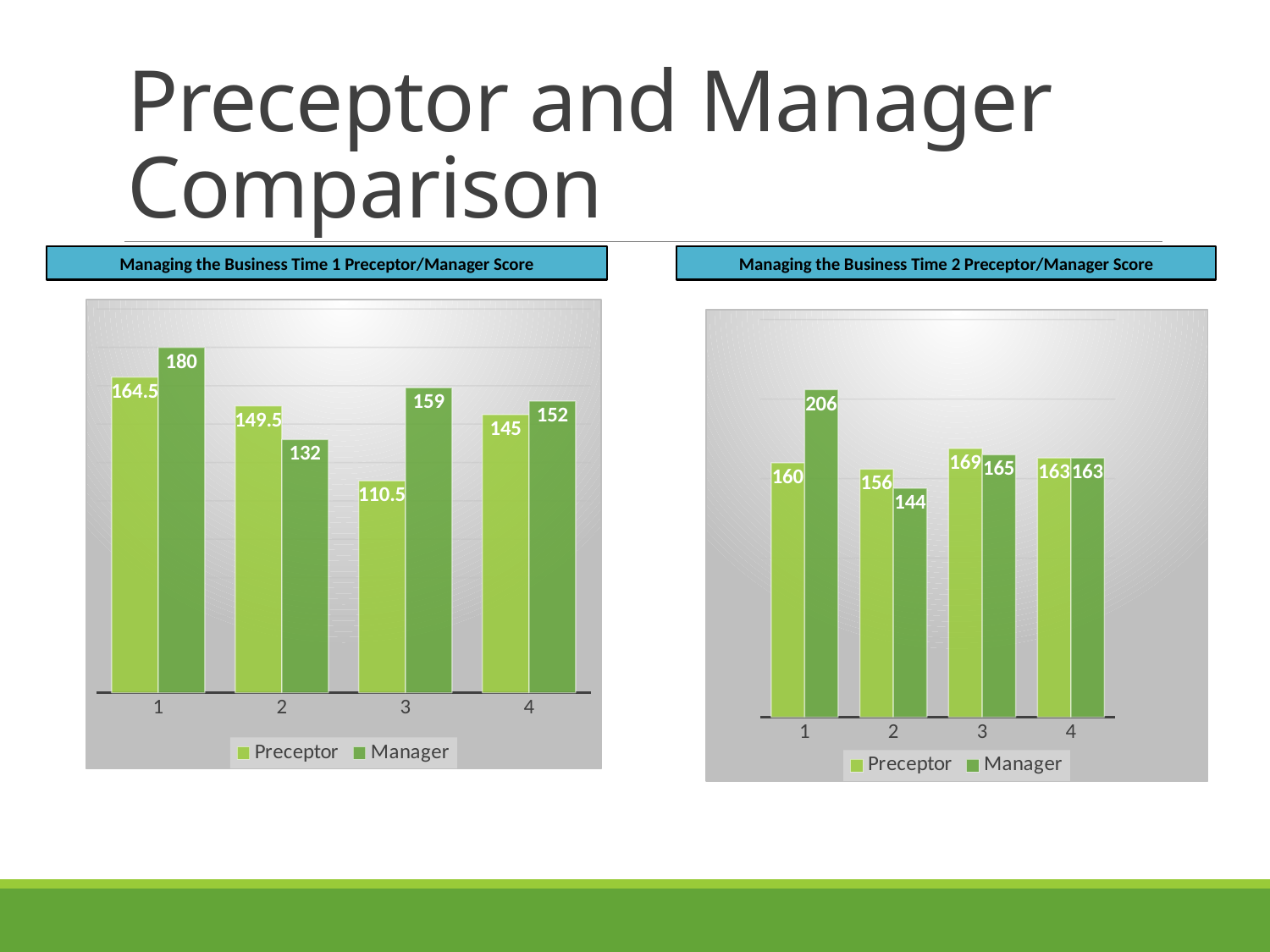
In the Time 2 chart (right), what is the Manager score for category 1? 206 In the Time 1 chart (left), what is the Manager score for category 3? 159 In the Time 2 chart (right), which category has the highest Manager score? 1 How many categories are shown on the x axis of the Time 2 chart (right)? 4 In the Time 1 chart (left), which is larger for category 2, the Preceptor score or the Manager score? Preceptor In the Time 1 chart (left), what is the difference between the Manager and Preceptor scores for category 3? 48.5 In the Time 2 chart (right), what is the Preceptor score for category 2? 156 What type of chart is the Time 2 chart (right)? Bar chart How many series does the legend of the Time 1 chart (left) list? 2 In the Time 1 chart (left), which category has the lowest Preceptor score? 3 In the Time 2 chart (right), what is the difference between the Preceptor and Manager scores for category 2? 12 In the Time 1 chart (left), what is the Preceptor score for category 1? 164.5